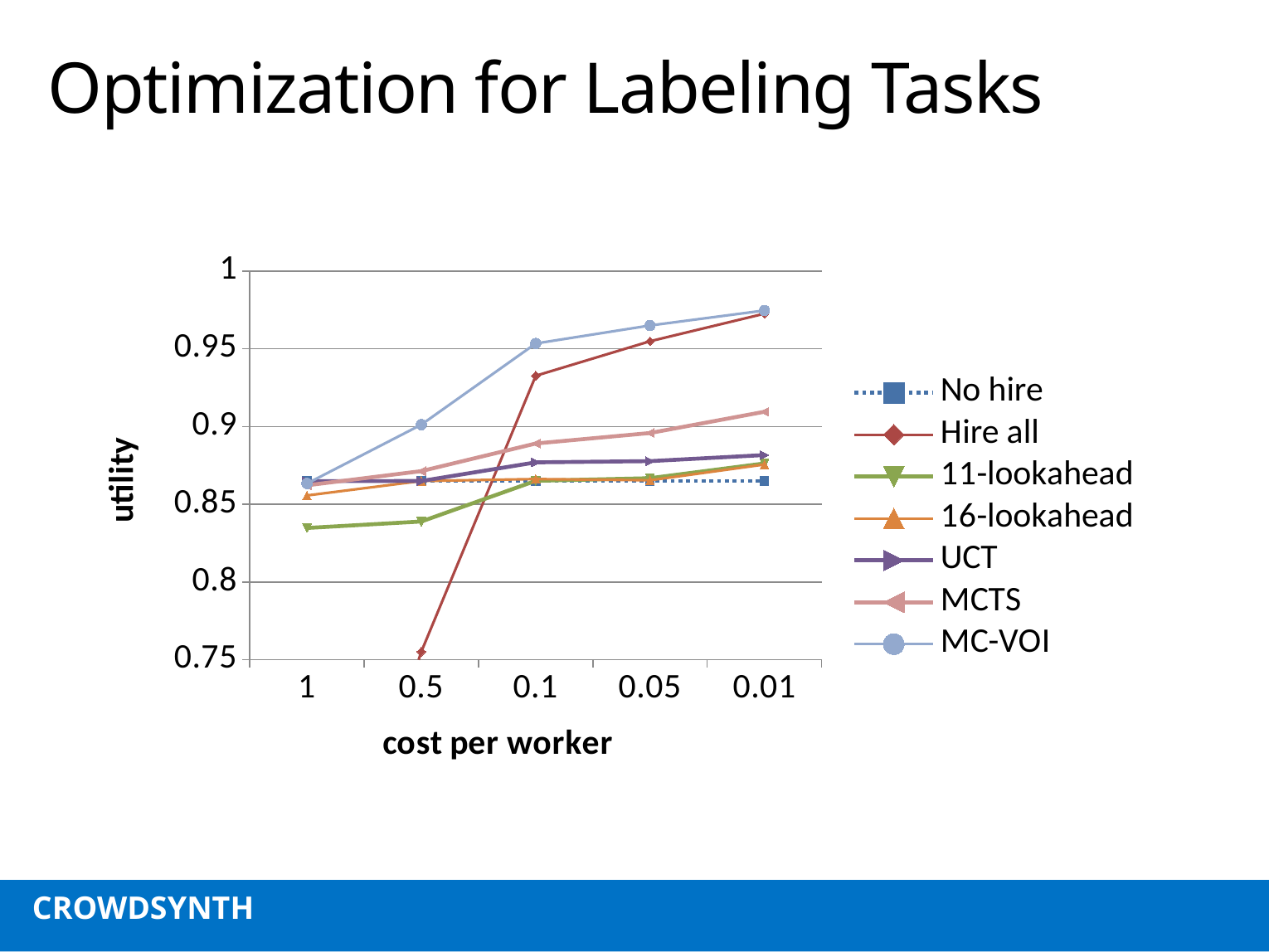
Which series has the lowest utility at cost per worker 0.5? Hire all How many series does the legend list? 7 What is the label of the x axis? cost per worker Is the utility for 11-lookahead at cost per worker 1 greater or less than 0.85? less Which series has the highest utility at cost per worker 0.1? MC-VOI At cost per worker 0.01, which has the higher utility, MCTS or UCT? MCTS Is the utility for MC-VOI at cost per worker 0.1 greater or less than 0.9? greater Is the utility for Hire all at cost per worker 0.5 greater or less than 0.8? less What kind of chart is shown on the slide? line chart How many cost per worker values are plotted along the x axis? 5 Does the utility for MC-VOI rise or fall moving from cost per worker 1 to 0.01 along the x axis? rise